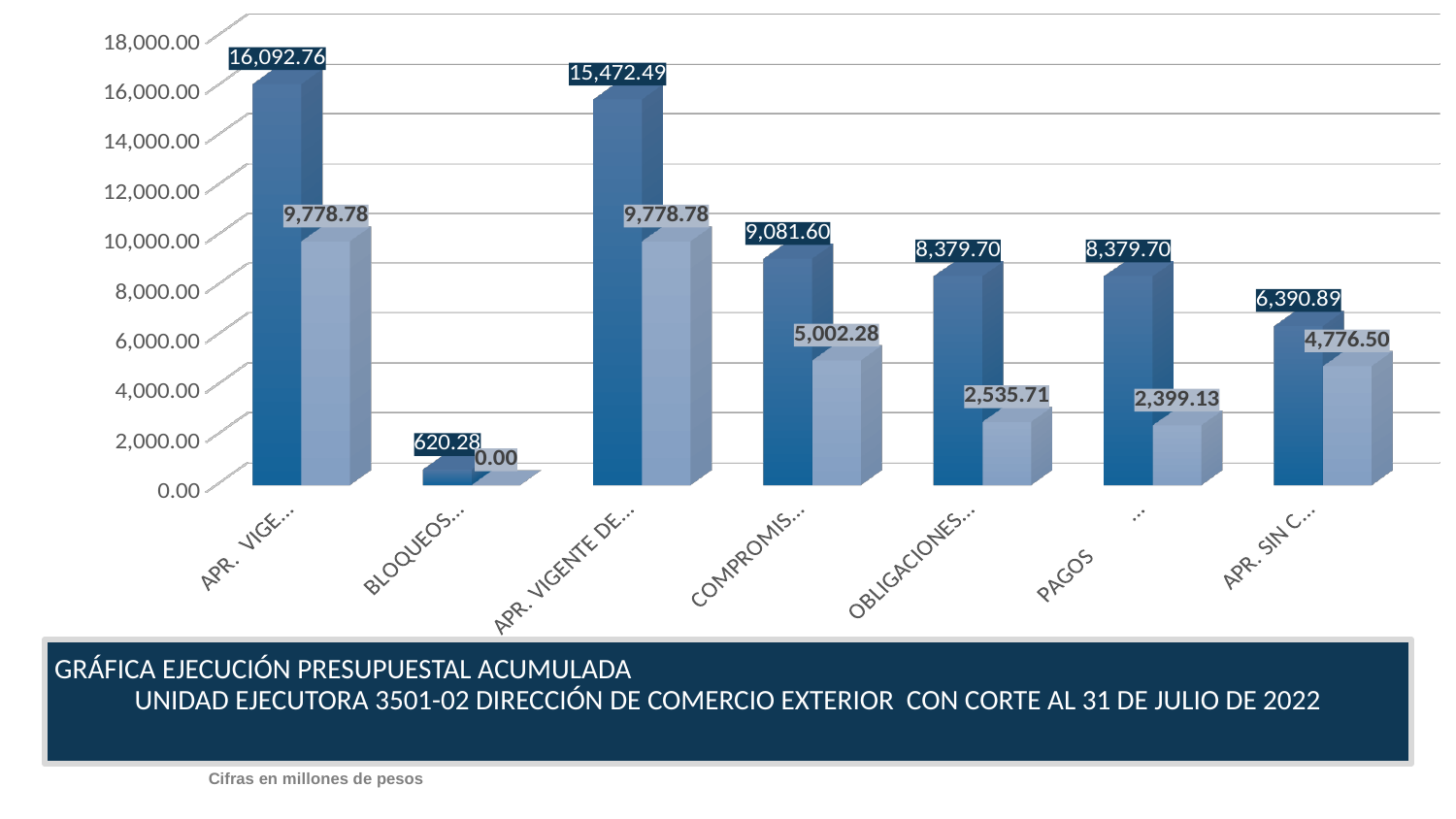
What is the value of the dark blue bar for BLOQUEOS? 620.28 According to the note below the chart, in what units are the figures expressed? Millones de pesos What kind of chart is shown on the slide? Bar chart What is the highest value shown by any dark blue bar? 16,092.76 How many categories are plotted along the x axis of the chart? 7 How many data series (bar colours) are plotted for each category? 2 Which is larger: the light blue bar for OBLIGACIONES or the light blue bar for PAGOS? OBLIGACIONES What is the value of the light blue bar for PAGOS? 2,399.13 What is the value of the dark blue bar for PAGOS? 8,379.70 Which category has the lowest dark blue bar? BLOQUEOS What is the difference between the dark blue and light blue bars for PAGOS? 5,980.57 What is the value of the light blue bar for BLOQUEOS? 0.00